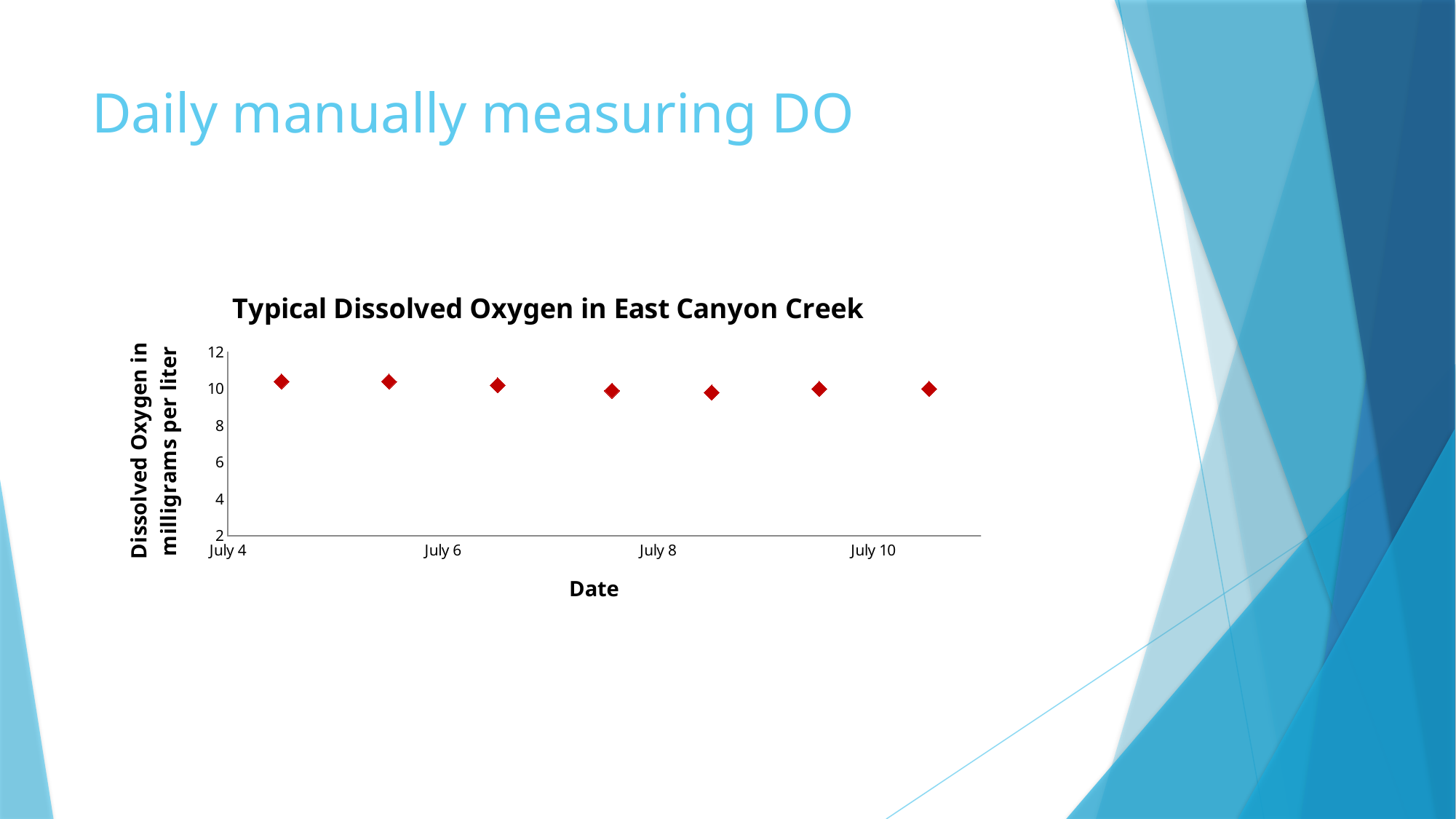
Are all of the plotted dissolved oxygen values greater or less than 4? greater Is the value of the fourth plotted point greater or less than 6? greater What kind of chart is shown on the slide? Scatter chart What is the title of the chart? Typical Dissolved Oxygen in East Canyon Creek Is the value of the last plotted point greater or less than 12? less What is the label of the y axis? Dissolved Oxygen in milligrams per liter How many data points are plotted on the chart? 7 Is the value of the first plotted point larger or smaller than the value of the fifth plotted point? larger